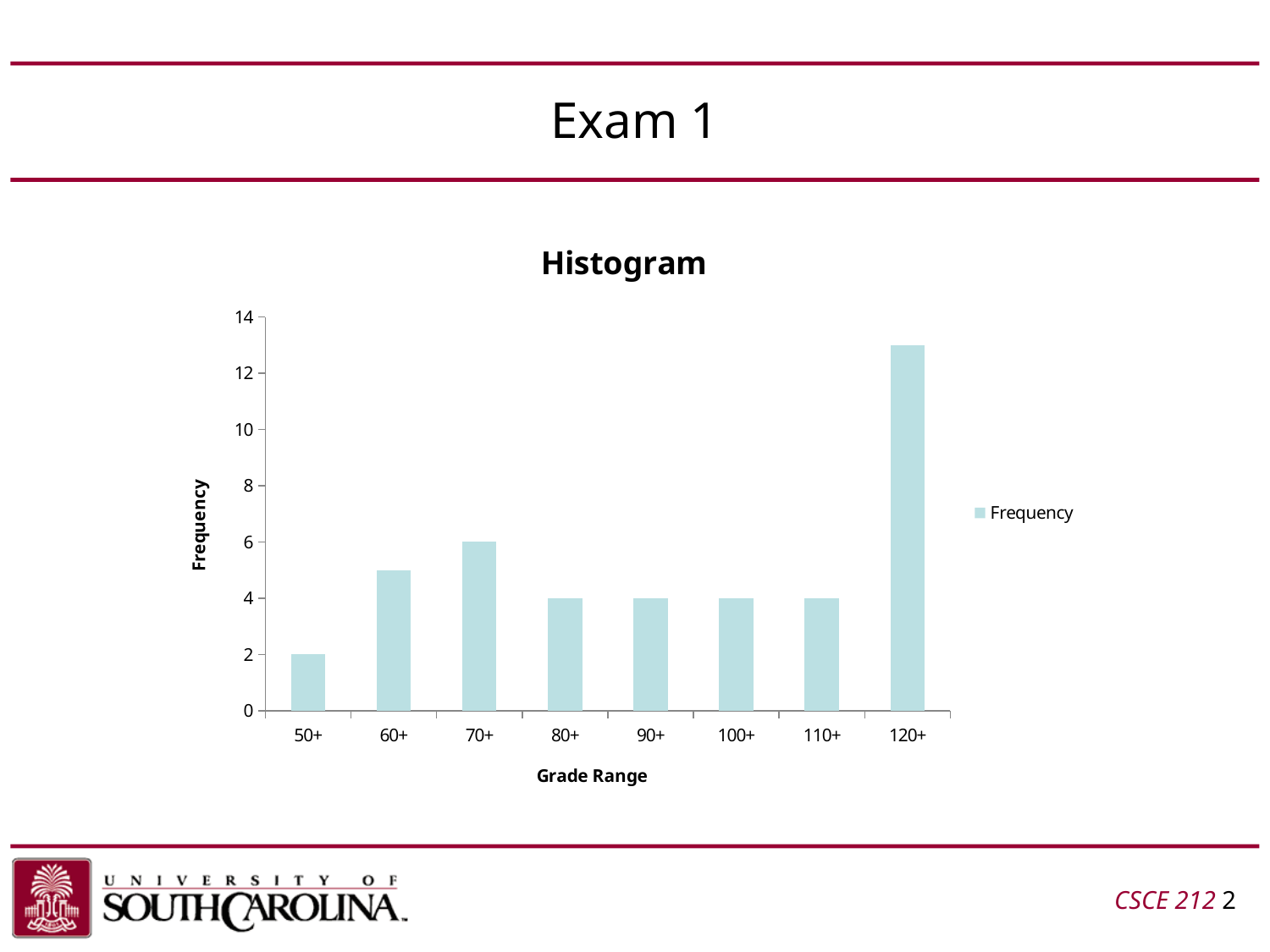
Which has a larger frequency, the 70+ range or the 80+ range? 70+ What is the frequency for the 90+ grade range? 4 How many series does the legend list? 1 Is the frequency for the 120+ grade range greater or less than 12? greater What is the difference between the frequency for 70+ and the frequency for 50+? 4 How many grade ranges are shown on the x axis? 8 Is the frequency for the 60+ grade range greater or less than 4? greater What is the frequency for the 70+ grade range? 6 Which grade range has the lowest frequency? 50+ Which grade range has the highest frequency? 120+ What is the frequency for the 50+ grade range? 2 What kind of chart is shown on the slide? bar chart